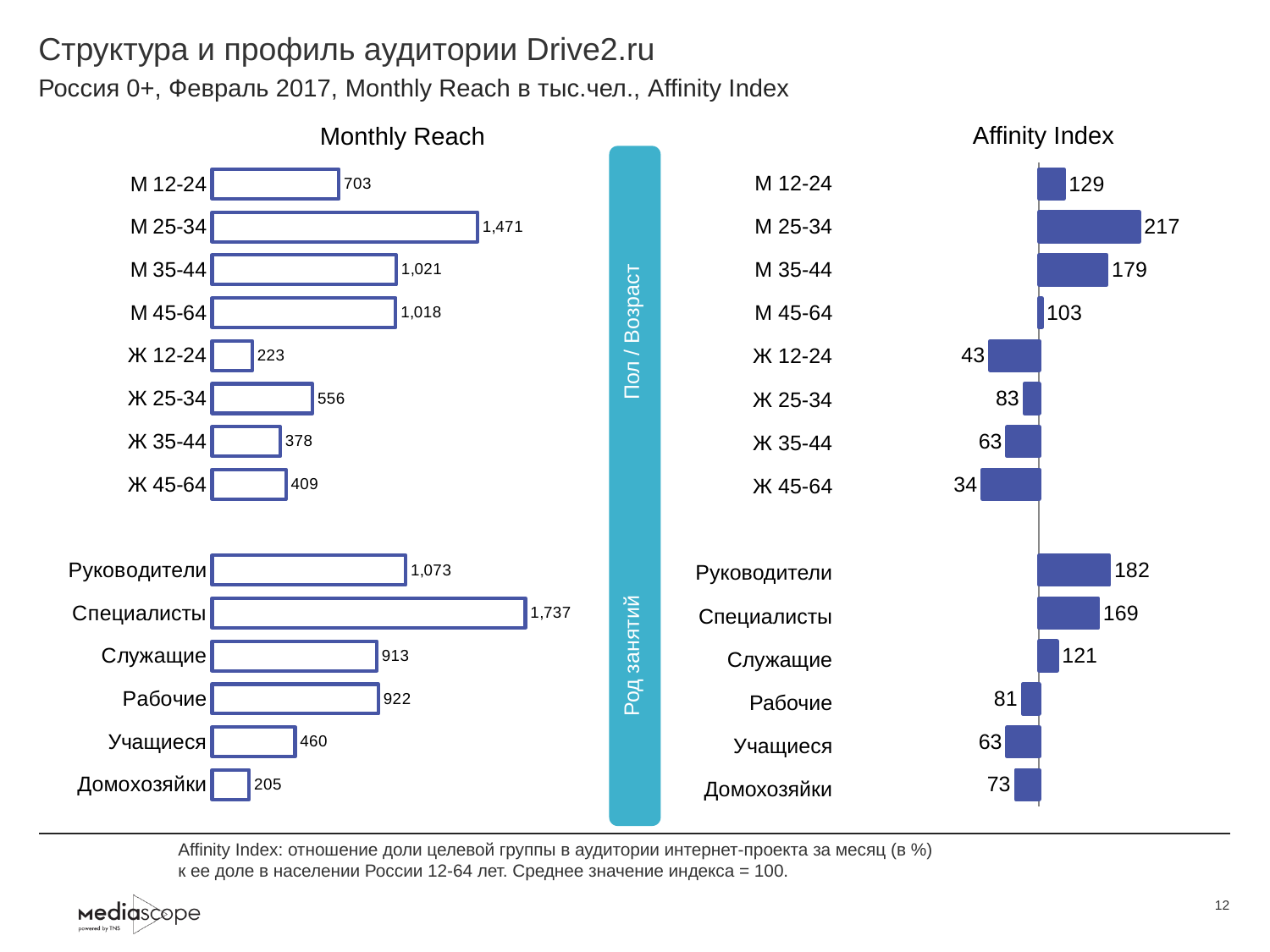
In the Monthly Reach chart, which is larger: Рабочие or Служащие? Рабочие In the Affinity Index chart, what is the difference between М 25-34 and Ж 25-34? 134 In the Monthly Reach chart, what is the difference between Специалисты and Руководители? 664 What are the two group labels shown on the vertical band between the charts? Пол / Возраст and Род занятий In the Affinity Index chart, what is the value for Руководители? 182 In the Affinity Index chart, which category has the lowest value? Ж 45-64 In the Monthly Reach chart, what is the value for Домохозяйки? 205 What type of chart is the Affinity Index chart? Bar chart In the Monthly Reach chart, what is the value for М 25-34? 1,471 In the Monthly Reach chart, how many categories are shown? 14 In the Monthly Reach chart, which category has the highest value? Специалисты In the Affinity Index chart, which is larger: М 35-44 or Служащие? М 35-44